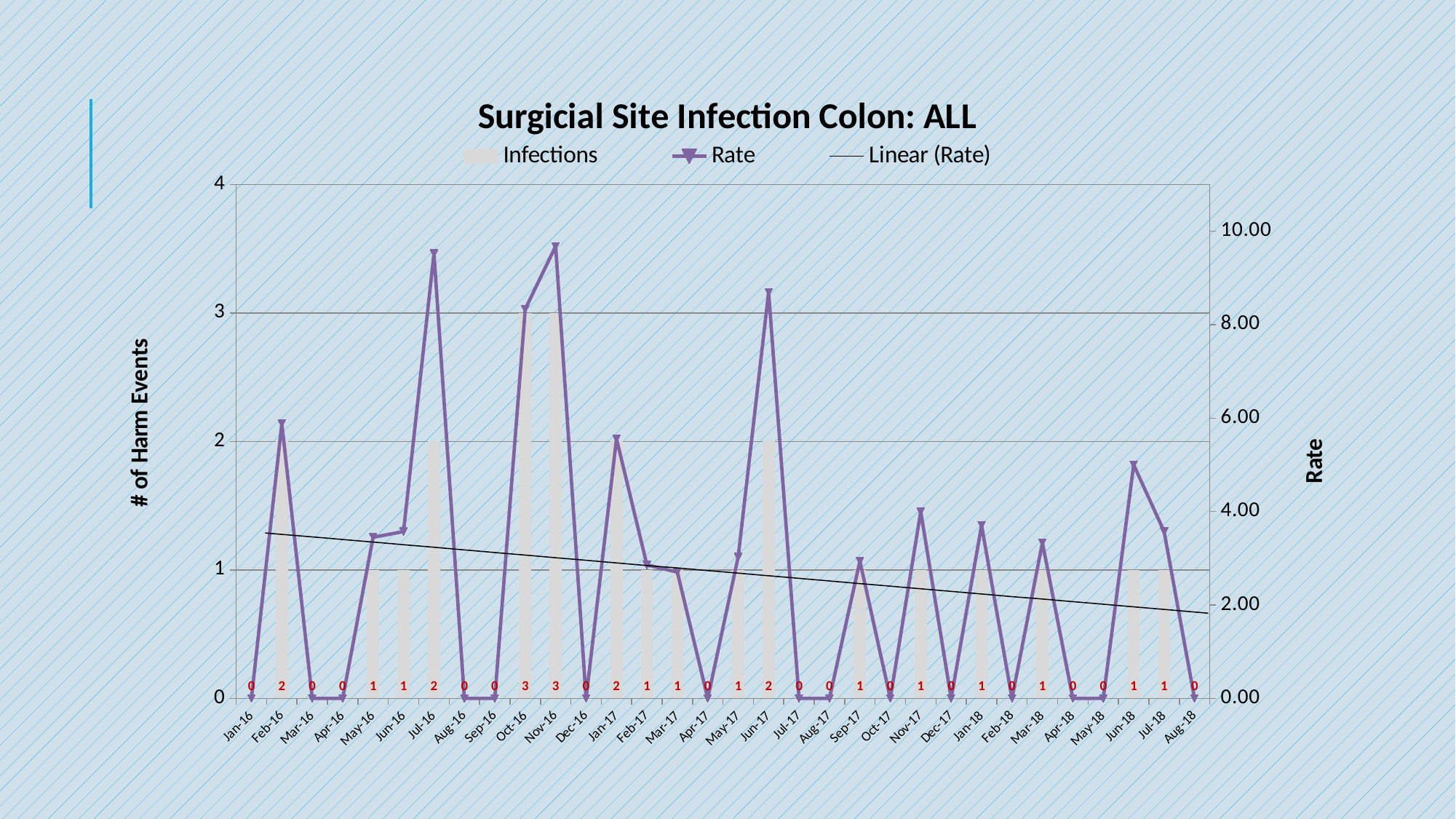
How many infections are shown for Jan-17? 2 How many series does the legend list? 3 Does the Linear (Rate) trendline rise or fall from Jan-16 to Aug-18? fall What is the difference in infections between Nov-16 and Feb-16? 1 Is the Rate value for Jun-18 greater or less than 4.00? greater Which month has more infections, Jul-16 or Mar-17? Jul-16 What is the title of the chart? Surgicial Site Infection Colon: ALL How many infections are shown for Jun-18? 1 Is the Rate value for Nov-16 greater or less than 8.00? greater What is the highest number of infections recorded in any month? 3 How many infections are shown for Oct-16? 3 How many months are shown on the x axis? 32